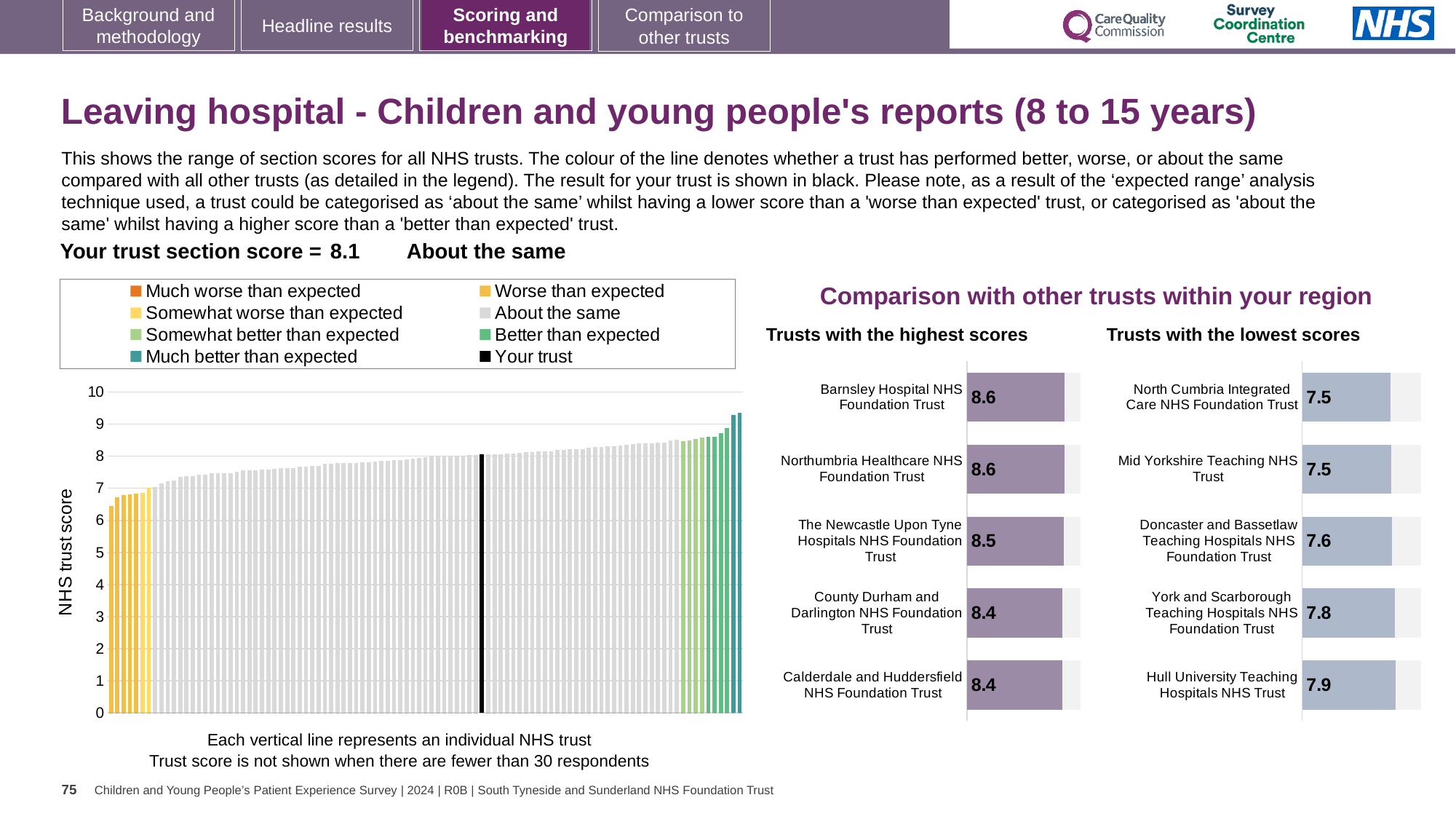
In the 'Trusts with the lowest scores' chart, which has the larger score: Doncaster and Bassetlaw Teaching Hospitals NHS Foundation Trust or York and Scarborough Teaching Hospitals NHS Foundation Trust? York and Scarborough Teaching Hospitals NHS Foundation Trust In the main chart on the left showing all NHS trusts, is the value of the lowest bar greater or less than 7? less In the main chart on the left showing all NHS trusts, do the values rise or fall from left to right? rise In the 'Trusts with the highest scores' chart, what is the score for Barnsley Hospital NHS Foundation Trust? 8.6 In the 'Trusts with the lowest scores' chart, which trust has the highest score? Hull University Teaching Hospitals NHS Trust In the 'Trusts with the lowest scores' chart, what is the difference between the scores of Hull University Teaching Hospitals NHS Trust and North Cumbria Integrated Care NHS Foundation Trust? 0.4 In the main chart on the left showing all NHS trusts, what is the score of the trust shown in black (your trust)? 8.1 How many trusts are listed in the 'Trusts with the highest scores' chart? 5 In the 'Trusts with the highest scores' chart, what is the score for The Newcastle Upon Tyne Hospitals NHS Foundation Trust? 8.5 In the 'Trusts with the lowest scores' chart, what is the score for Hull University Teaching Hospitals NHS Trust? 7.9 In the 'Trusts with the highest scores' chart, what is the difference between the scores of Barnsley Hospital NHS Foundation Trust and Calderdale and Huddersfield NHS Foundation Trust? 0.2 How many entries does the legend of the main chart on the left list? 8